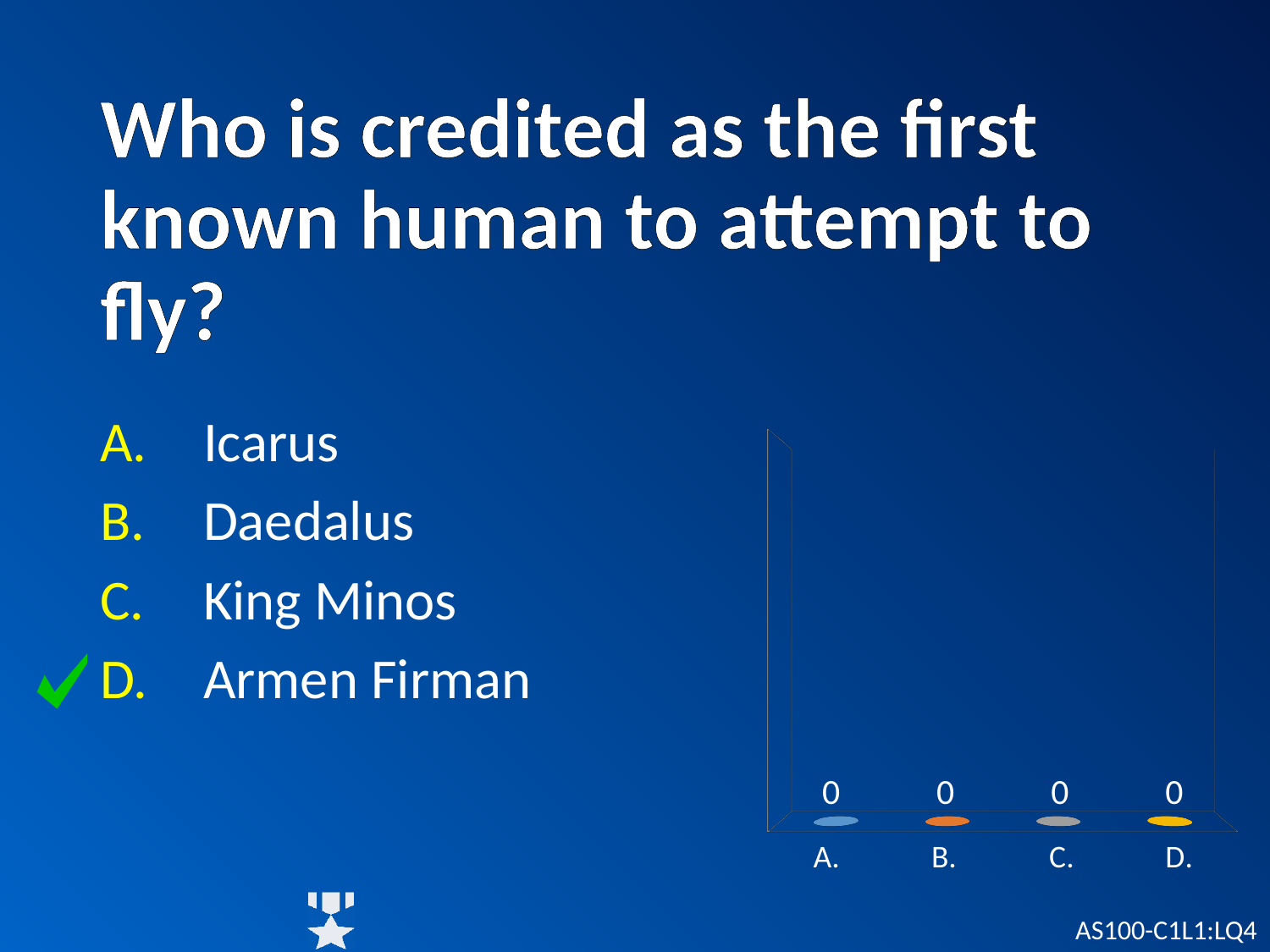
What is the difference between the values for A. and D. in the chart? 0 What kind of chart is shown on the slide? bar chart What value is shown for category B. in the chart? 0 What are the category labels along the x axis of the chart? A., B., C., D. What value is shown for category C. in the chart? 0 What value is shown for category D. in the chart? 0 What value is shown for category A. in the chart? 0 How many categories are plotted in the chart? 4 What is the difference between the values for B. and C. in the chart? 0 What colour is the bar for category B. in the chart? orange